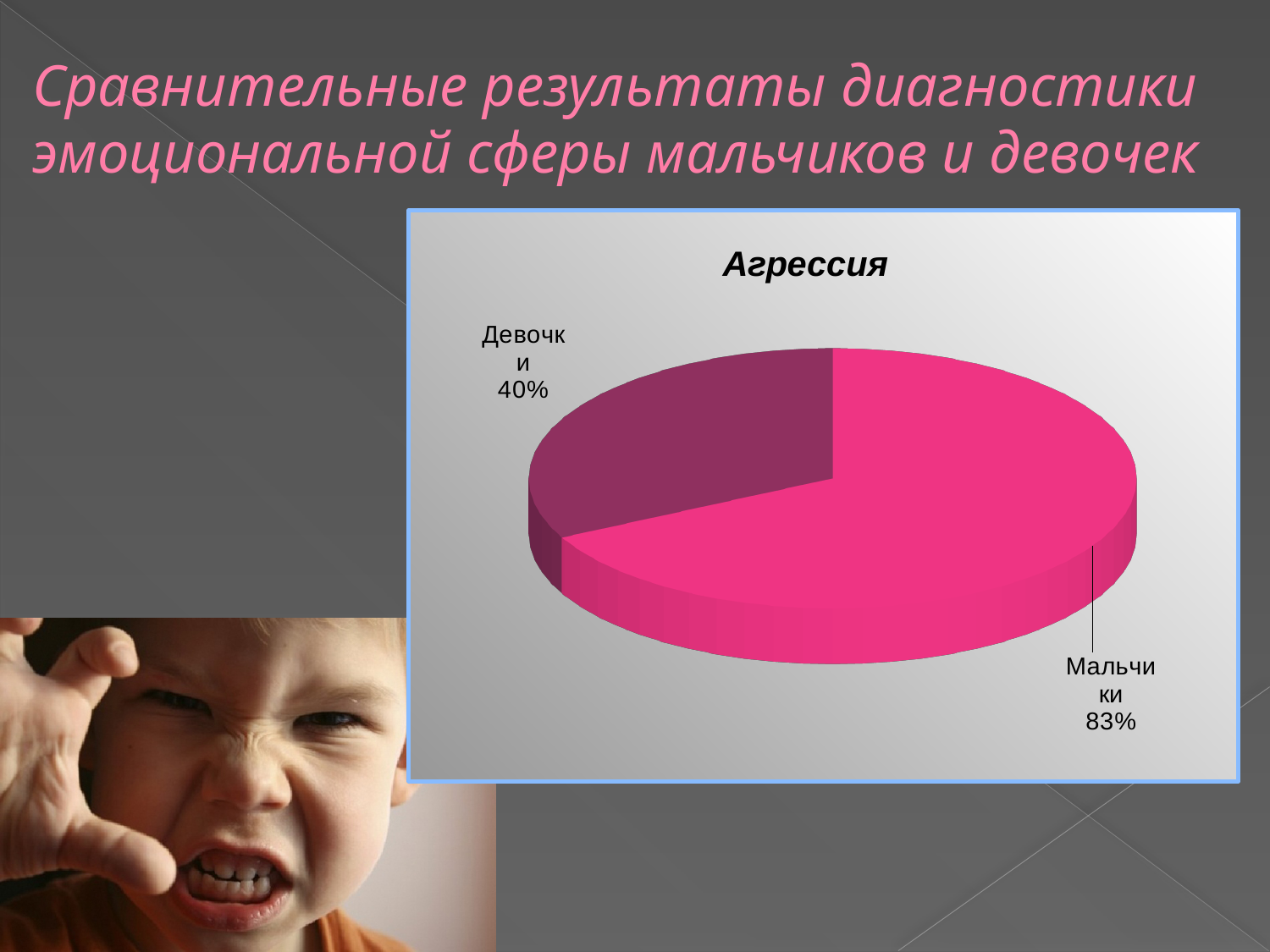
What share of the pie is labelled for Девочки? 40% What share of the pie is labelled for Мальчики? 83% Which category has the smallest slice in the pie chart? Девочки Which slice is drawn in the darker shade of pink/purple? Девочки How many slices does the pie chart have? 2 What kind of chart is shown on the slide? pie chart What is the title of the chart? Агрессия Which is larger, the value for Мальчики or the value for Девочки? Мальчики What is the difference between the value for Мальчики and the value for Девочки? 43% What value is shown for Девочки in the chart? 40% Which category has the largest slice in the pie chart? Мальчики What value is shown for Мальчики in the chart? 83%